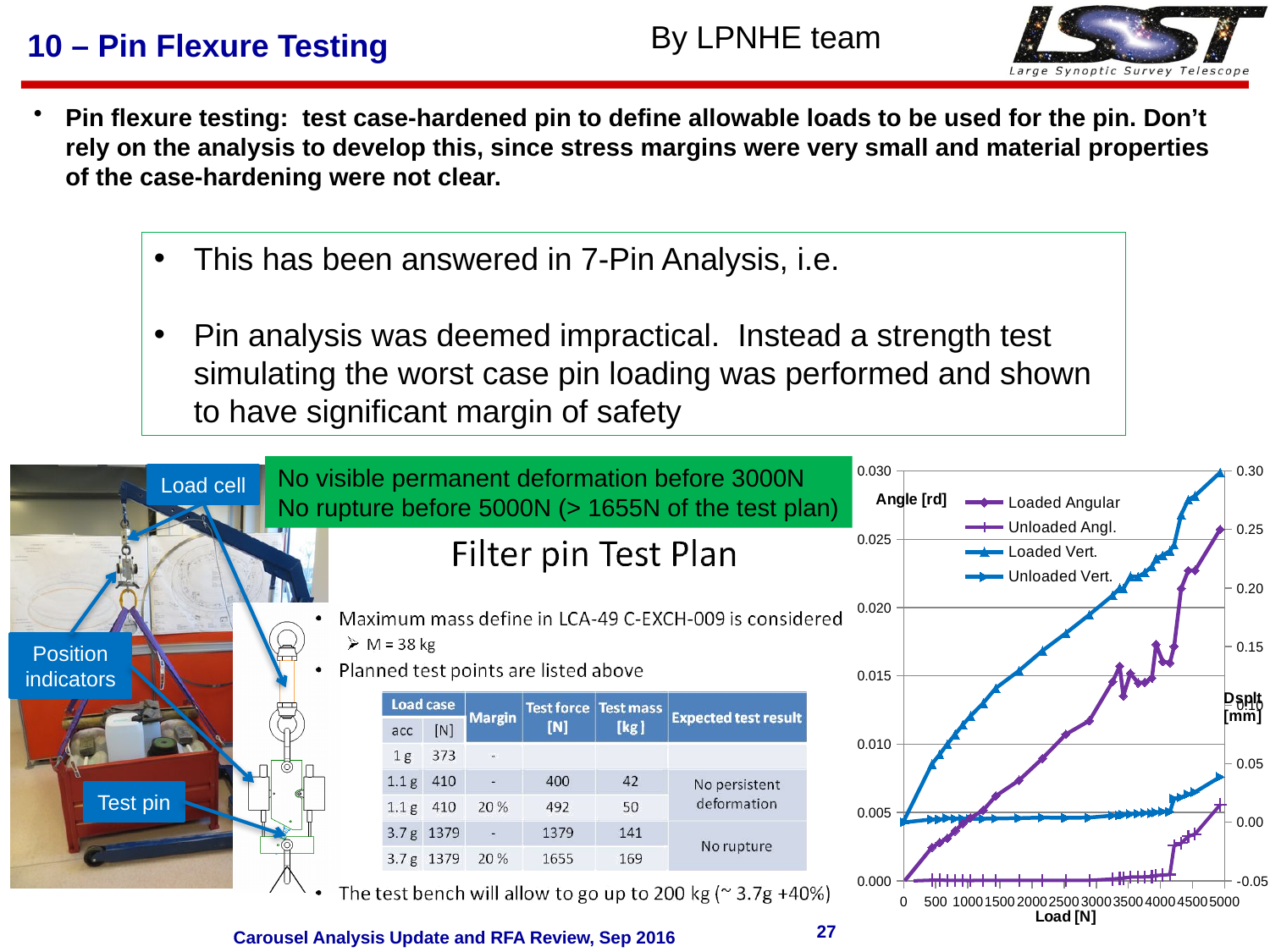
How many series does the legend of the chart on the right list? 4 What label is shown for the left vertical axis of the chart on the right? Angle [rd] What is the title of the x axis of the chart on the right? Load [N] In the chart on the right, at 5000 N, which is higher: the Loaded Vert. line or the Unloaded Vert. line? Loaded Vert. What kind of chart is shown on the right side of the slide? line chart In the chart on the right, does the Loaded Vert. series rise or fall as the load increases from 0 to 5000 N? rise In the chart on the right, read against the left axis, is the Loaded Angular value at 1000 N greater or less than 0.010? less In the chart on the right, read against the left axis, is the Loaded Angular value at 5000 N greater or less than 0.020? greater In the chart on the right, which series reaches the highest point on the plot at 5000 N? Loaded Vert. In the chart on the right, does the Loaded Angular series generally rise or fall as the load increases? rise In the chart on the right, at 5000 N, which is higher: the Loaded Angular line or the Unloaded Angl. line? Loaded Angular In the chart on the right, which series stays lowest across the whole load range? Unloaded Angl.